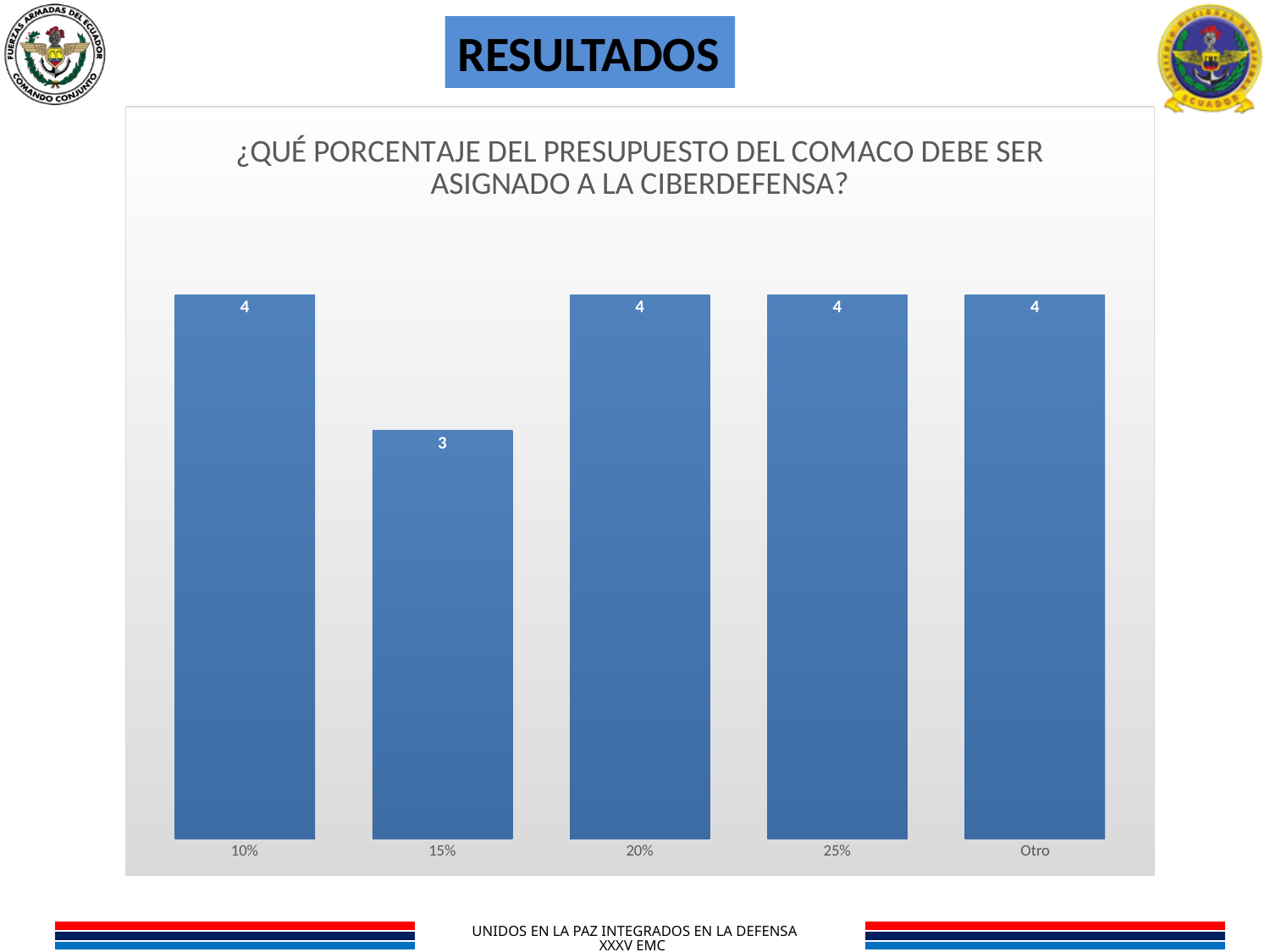
What is the value for the 10% category? 4 What is the value for the 15% category? 3 How many categories have a value of 4? 4 What is the title of the chart? ¿QUÉ PORCENTAJE DEL PRESUPUESTO DEL COMACO DEBE SER ASIGNADO A LA CIBERDEFENSA? What kind of chart is shown on the slide? bar chart Which category has the lowest value? 15% What is the value for the Otro category? 4 What is the difference between the values for 20% and 15%? 1 What is the label of the last category on the x axis? Otro How many categories are shown on the x axis? 5 Which is larger, the value for 25% or the value for 15%? 25%